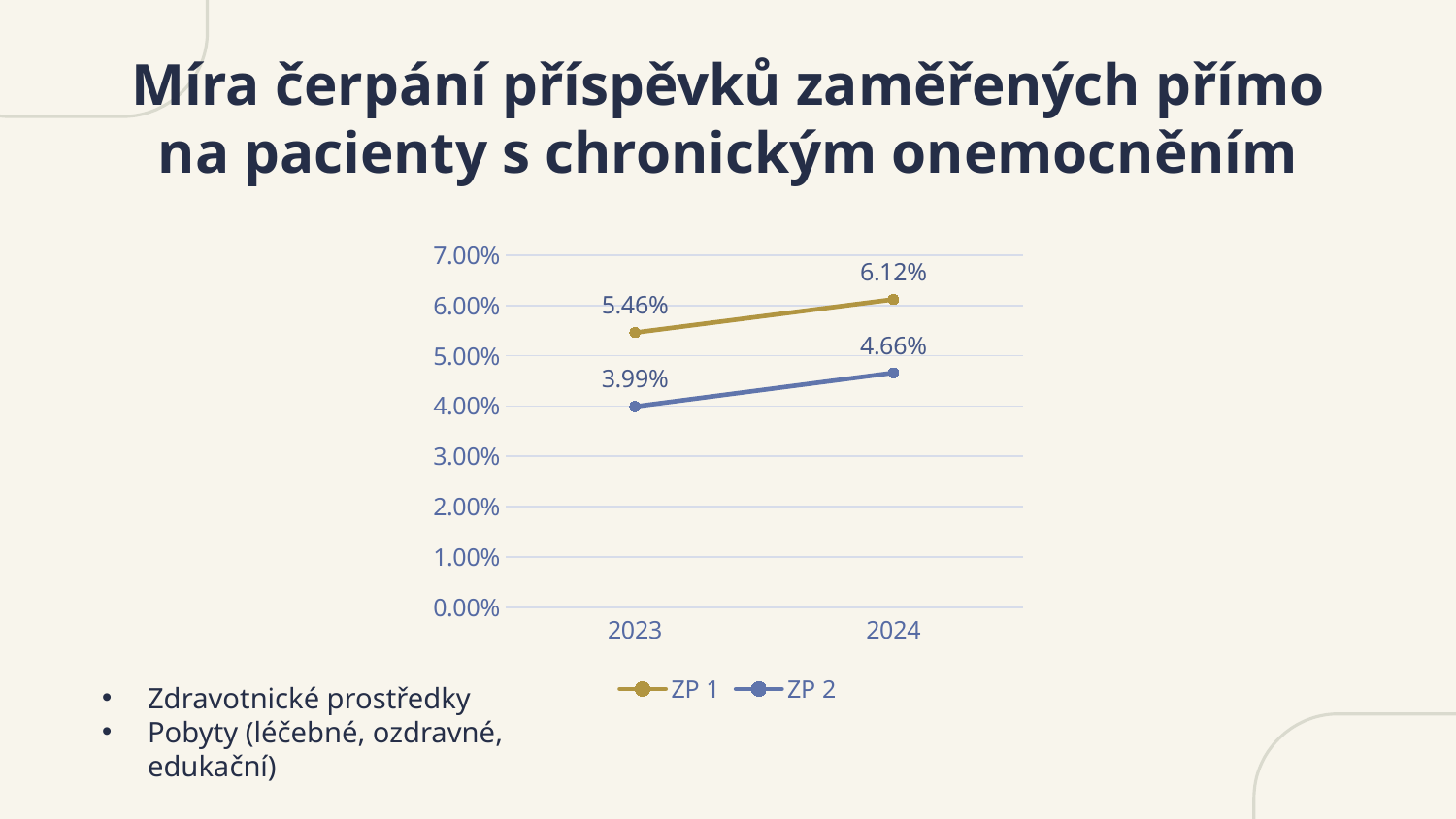
Which series has the higher value in 2024, ZP 1 or ZP 2? ZP 1 How many years are shown on the x axis? 2 What is the value for ZP 1 in 2024? 6.12% By how much did ZP 2 change from 2023 to 2024? 0.67% What is the value for ZP 2 in 2024? 4.66% Which series is drawn in blue? ZP 2 What kind of chart is shown on the slide? line chart What is the difference between ZP 1 and ZP 2 in 2023? 1.47% Does the value for ZP 1 rise or fall from 2023 to 2024? rise What is the value for ZP 1 in 2023? 5.46% How many series does the legend list? 2 What is the value for ZP 2 in 2023? 3.99%